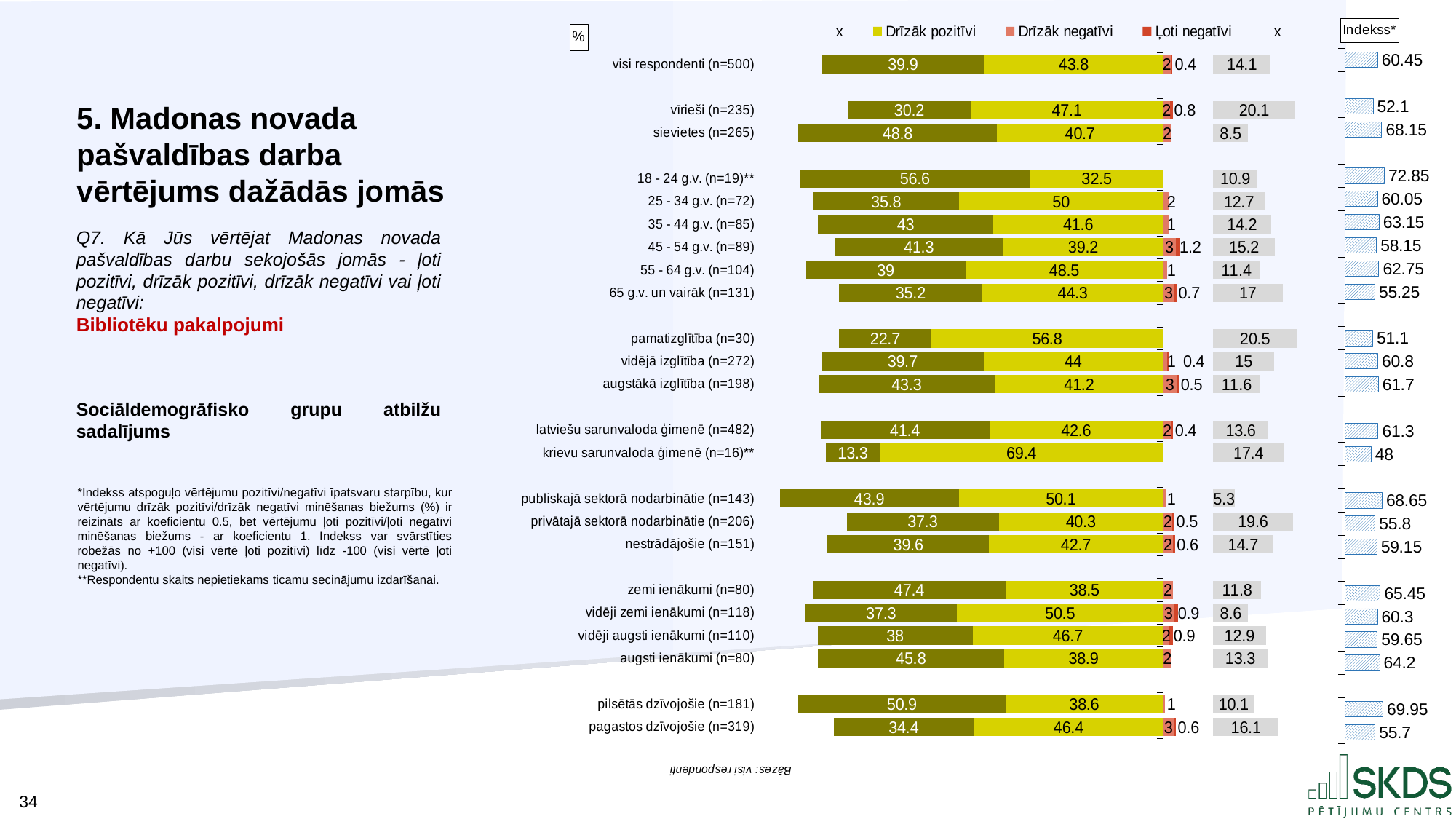
What is the combined value of the first two segments (dark olive and "Drīzāk pozitīvi") for visi respondenti (n=500)? 83.7 What kind of chart is used to show the respondent group ratings? stacked bar chart What is the value of the first (dark olive) segment for sievietes (n=265)? 48.8 Which has the higher Indekss* value: pilsētās dzīvojošie (n=181) or pagastos dzīvojošie (n=319)? pilsētās dzīvojošie (n=181) Which group has the highest "Drīzāk pozitīvi" value? krievu sarunvaloda ģimenē (n=16)** Which group has the lowest Indekss* value? krievu sarunvaloda ģimenē (n=16)** What is the value of the grey segment for vīrieši (n=235)? 20.1 What is the "Drīzāk pozitīvi" value for visi respondenti (n=500)? 43.8 What is the difference between the Indekss* values for sievietes (n=265) and vīrieši (n=235)? 16.05 How many respondent groups (bars) are shown in the chart? 23 Which group has the highest Indekss* value? 18 - 24 g.v. (n=19)** What is the Indekss* value for 18 - 24 g.v. (n=19)**? 72.85